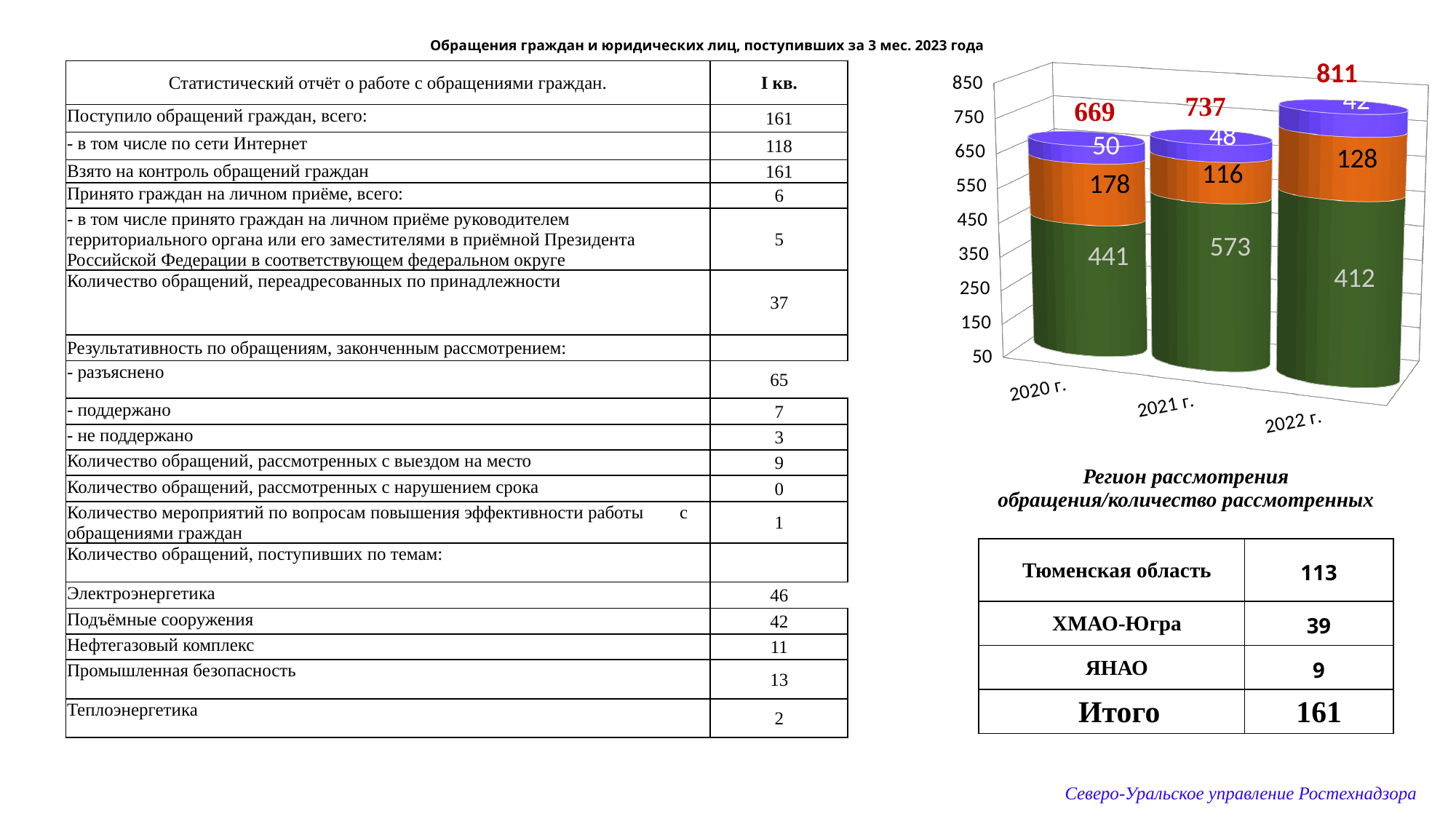
What total is printed above the bar for 2021 г.? 737 What is the value of the orange (middle) segment for 2021 г.? 116 What is the value of the purple (top) segment for 2020 г.? 50 Which year has the lowest total printed above its bar? 2020 г. What is the value of the orange (middle) segment for 2022 г.? 128 What is the difference between the green segment values for 2021 г. and 2020 г.? 132 Which is larger: the orange segment for 2020 г. or the orange segment for 2022 г.? 2020 г. What kind of chart is shown on the slide? bar chart What is the value of the green (bottom) segment for 2020 г.? 441 Which year has the highest total printed above its bar? 2022 г. Do the totals printed above the bars rise or fall from 2020 г. to 2022 г.? rise How many years (categories) are shown on the x axis of the chart? 3